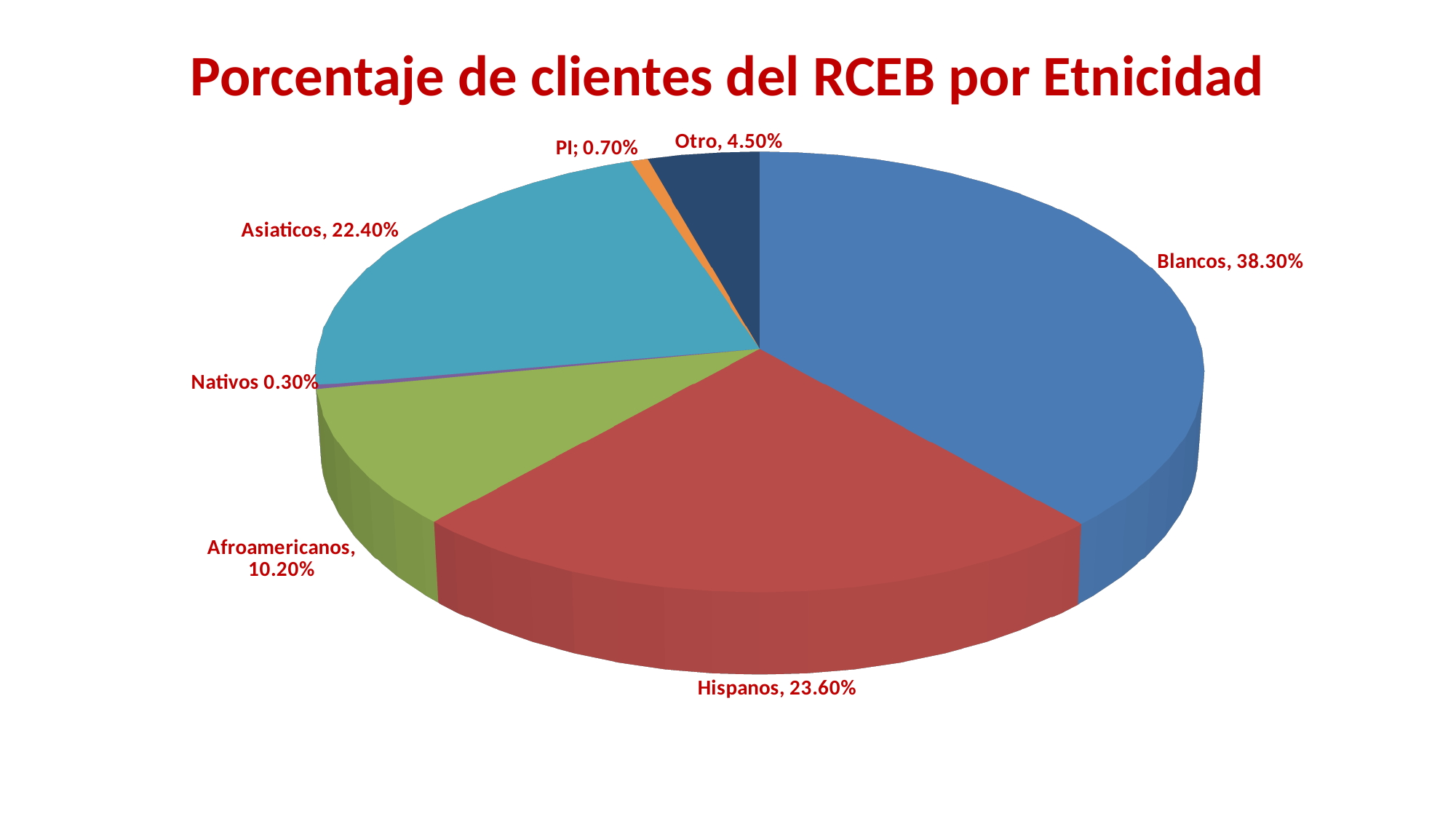
Which ethnicity has the largest share of RCEB clients? Blancos What is the title of the chart? Porcentaje de clientes del RCEB por Etnicidad What percentage of RCEB clients are Asiaticos? 22.40% What percentage of RCEB clients are labelled Otro? 4.50% Which ethnicity has the smallest share of RCEB clients? Nativos What kind of chart is shown on the slide? Pie chart Which is larger, the share for Hispanos or the share for Asiaticos? Hispanos What percentage of RCEB clients are Blancos? 38.30% What percentage of RCEB clients are Hispanos? 23.60% What is the difference in percentage points between Blancos and Hispanos? 14.70% What percentage of RCEB clients are Afroamericanos? 10.20% How many ethnicity categories are shown in the pie chart? 7